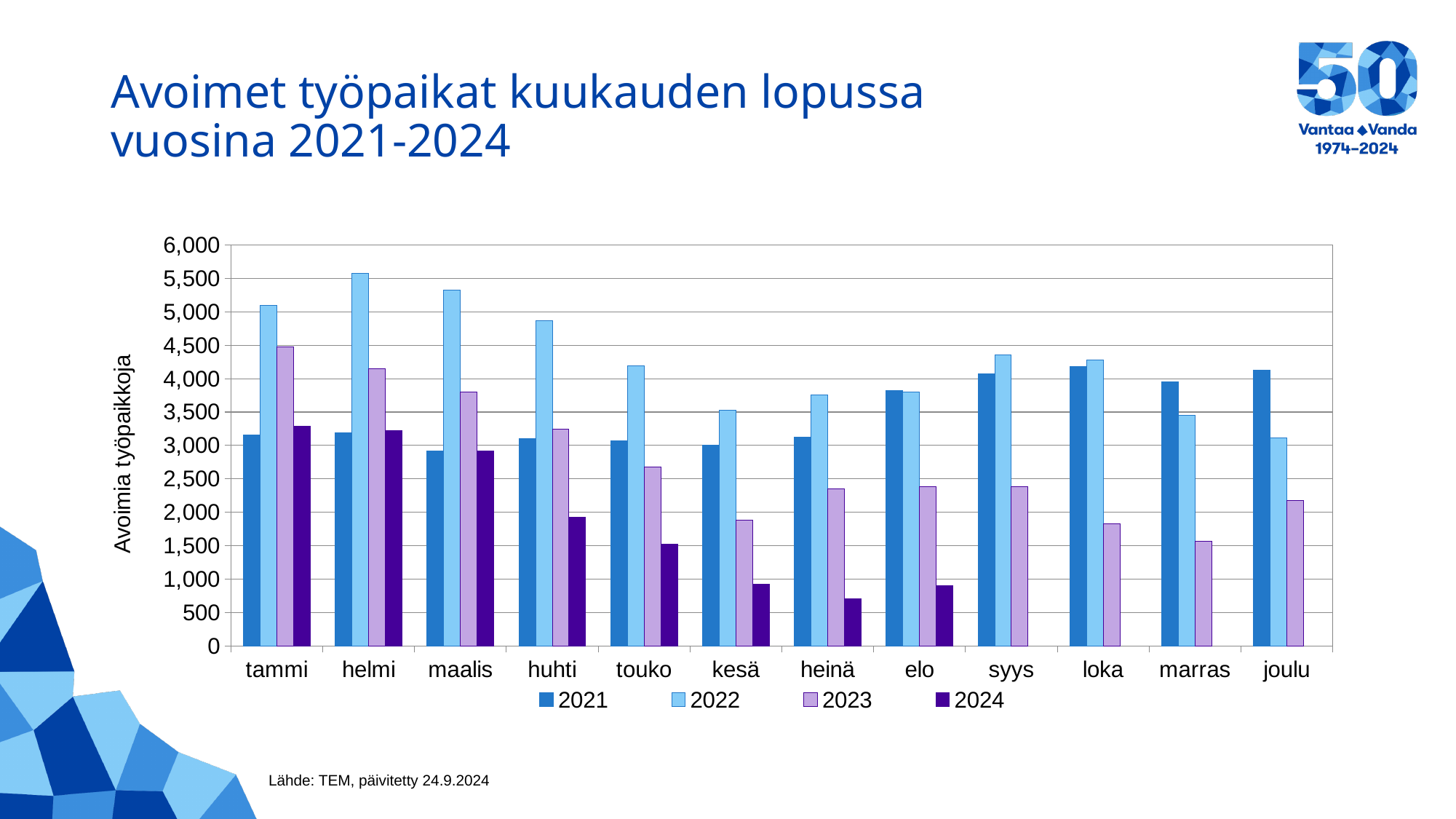
In joulu, which series has the larger value, 2021 or 2022? 2021 Is the 2024 value for heinä greater or less than 1,000? less Do the 2024 values rise or fall from tammi to elo? fall What kind of chart is shown on the slide? bar chart In which month is the 2023 value highest? tammi How many months are shown on the x axis? 12 Is the 2022 value for tammi greater or less than 5,000? greater In helmi, which series has the larger value, 2021 or 2022? 2022 Is the 2023 value for kesä greater or less than 2,000? less In which month is the 2024 value lowest? heinä How many series does the legend list? 4 In which month is the 2022 value highest? helmi